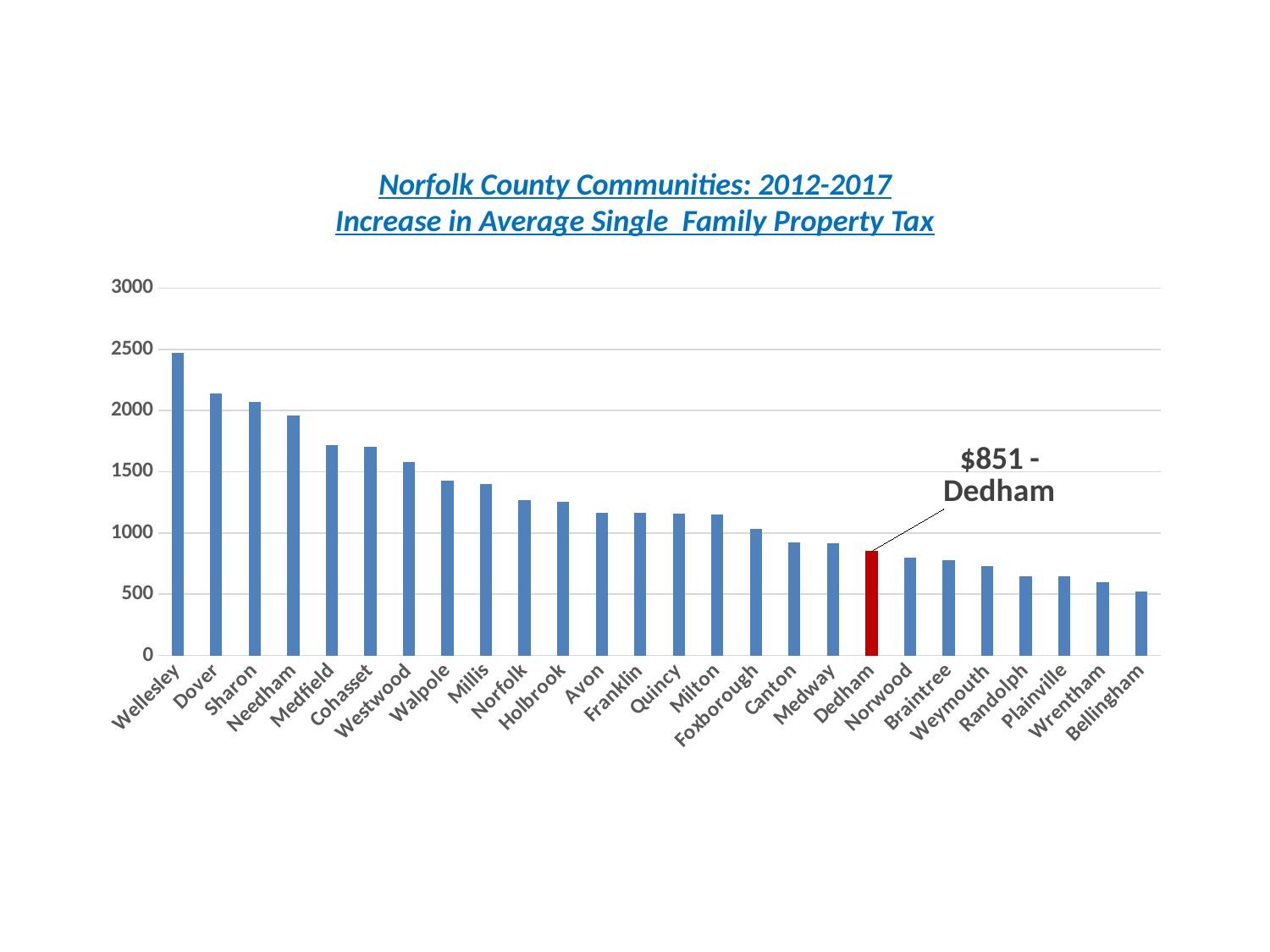
Is the value for Canton greater or less than 1000? less How many communities are plotted on the chart? 26 Do the values rise or fall moving from left to right along the x axis? Fall What is the value labelled for Dedham? $851 What is the title of the chart? Norfolk County Communities: 2012-2017 Increase in Average Single Family Property Tax Which community has the highest increase in average single family property tax? Wellesley Which community has the lowest increase in average single family property tax? Bellingham Is the value for Medfield greater or less than 1500? greater Which has the larger value, Wellesley or Dover? Wellesley Is the value for Dover greater or less than 2000? greater What colour is the bar for Dedham? Red What type of chart is shown on the slide? Bar chart